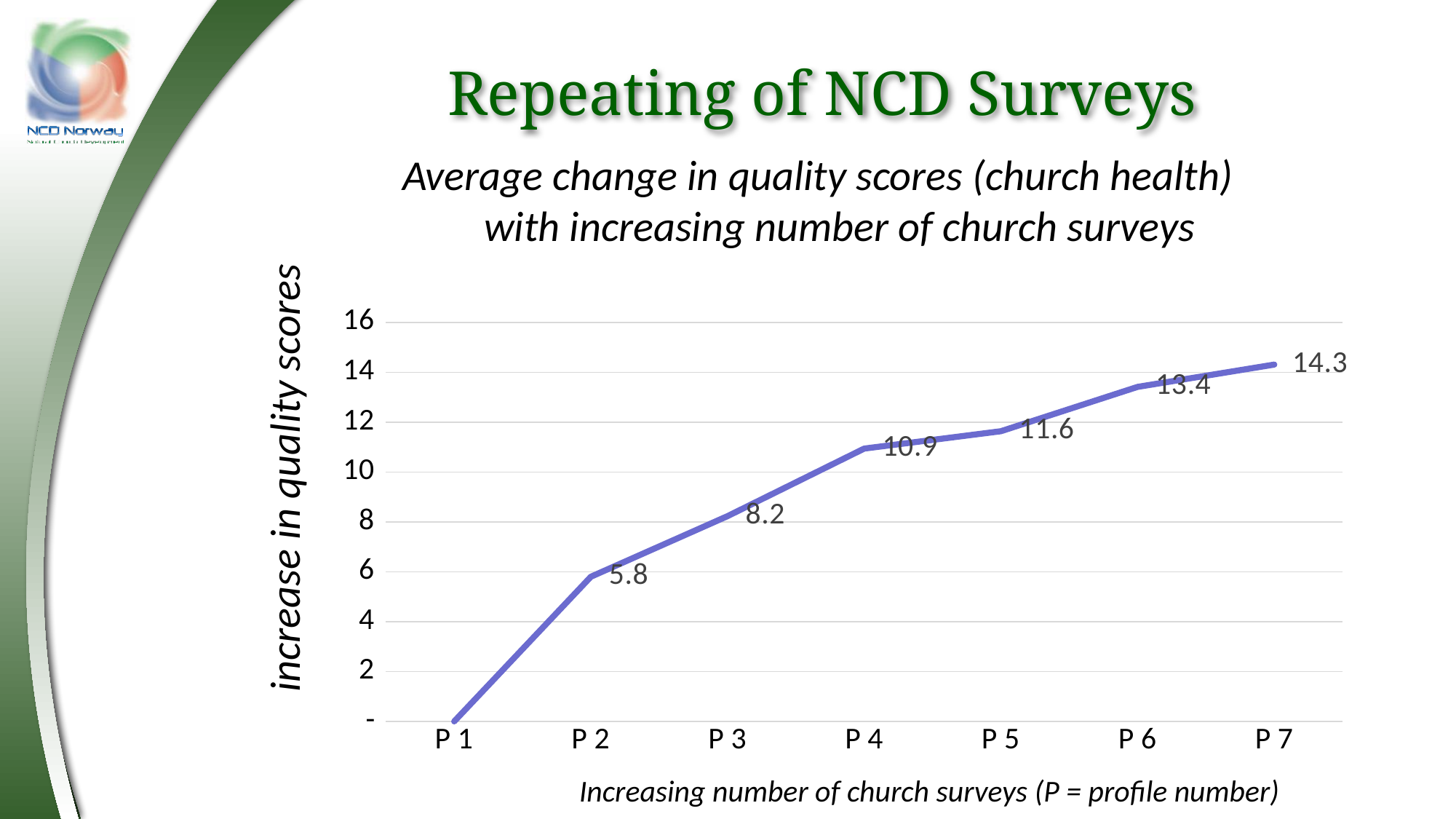
What is the value for P 7? 14.3 Which profile number has the highest value? P 7 Is the value for P 1 greater or less than 2? less How many profile numbers are plotted on the x axis? 7 What type of chart is shown on the slide? line chart What is the difference between the values for P 7 and P 2? 8.5 What is the value for P 6? 13.4 What is the value for P 2? 5.8 Do the values rise or fall from P 1 to P 7? rise Which is larger, the value for P 3 or the value for P 5? P 5 Which profile number has the lowest value? P 1 What is the value for P 4? 10.9